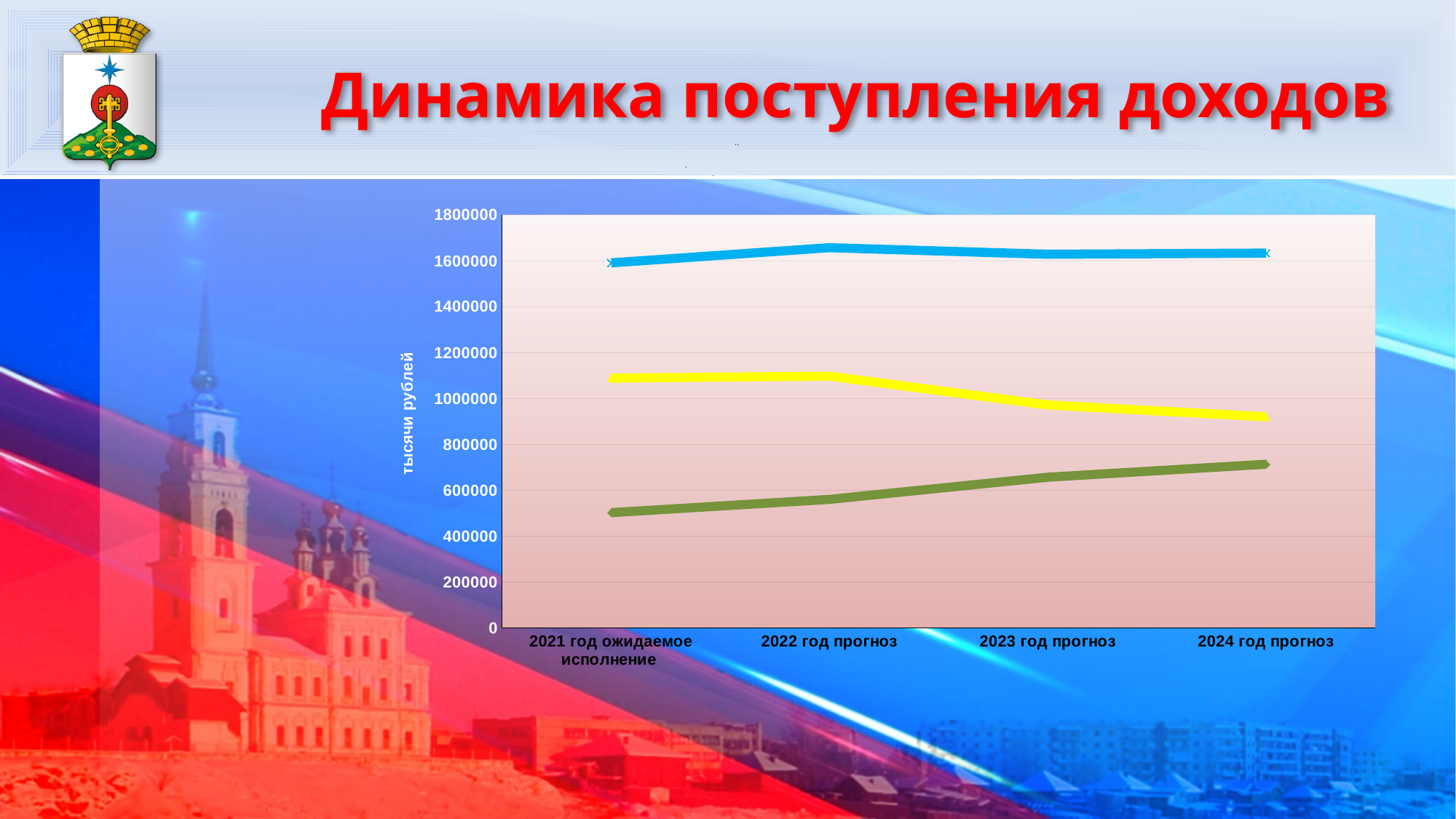
What is the title of the slide containing the chart? Динамика поступления доходов What is the label of the vertical axis of the chart? тысячи рублей Is the value of the green line for 2024 год прогноз greater or less than 600000? greater Is the value of the yellow line for 2021 год ожидаемое исполнение greater or less than 1000000? greater Does the yellow line rise or fall from 2022 год прогноз to 2024 год прогноз? fall What kind of chart is shown on the slide? line chart Which line has the highest values across all years: blue, yellow or green? blue Is the value of the yellow line for 2024 год прогноз greater or less than 1000000? less How many categories are shown on the x axis of the chart? 4 Does the green line rise or fall from 2021 год ожидаемое исполнение to 2024 год прогноз? rise